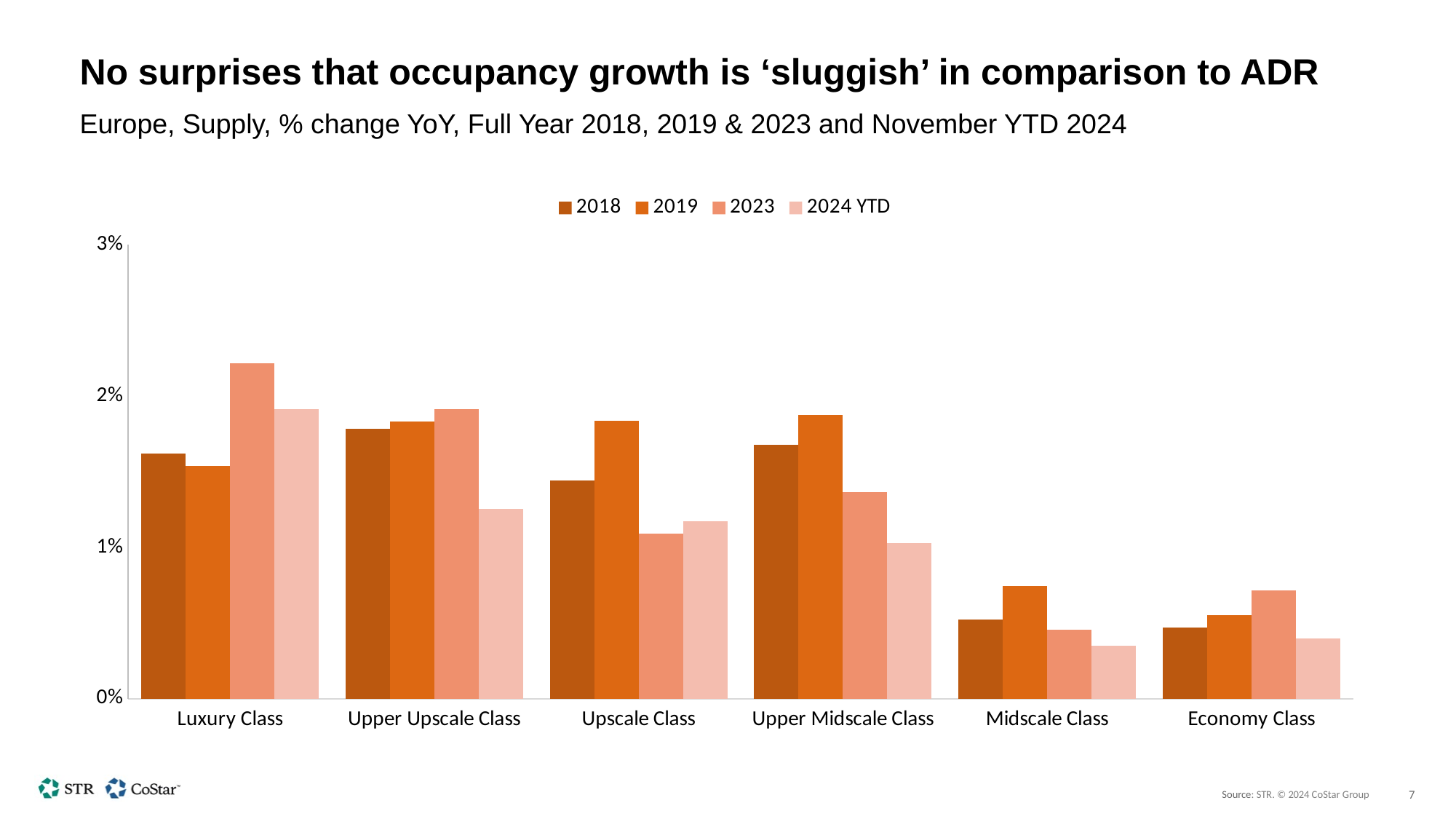
Is the 2024 YTD value for Upper Upscale Class greater or less than 1%? greater How many hotel classes are shown on the x axis? 6 What kind of chart is shown on the slide? bar chart Which series and class combination has the tallest bar in the chart? 2023, Luxury Class Which is larger: the 2024 YTD value for Luxury Class or the 2024 YTD value for Upper Upscale Class? Luxury Class Which class has the lowest value for the 2019 series? Economy Class For Upscale Class, which is larger: the 2019 value or the 2023 value? 2019 How many series does the legend list? 4 What are the entries listed in the legend? 2018, 2019, 2023, 2024 YTD Is the 2023 value for Luxury Class greater or less than 2%? greater Which class has the highest value for the 2023 series? Luxury Class Is the 2019 value for Midscale Class greater or less than 1%? less